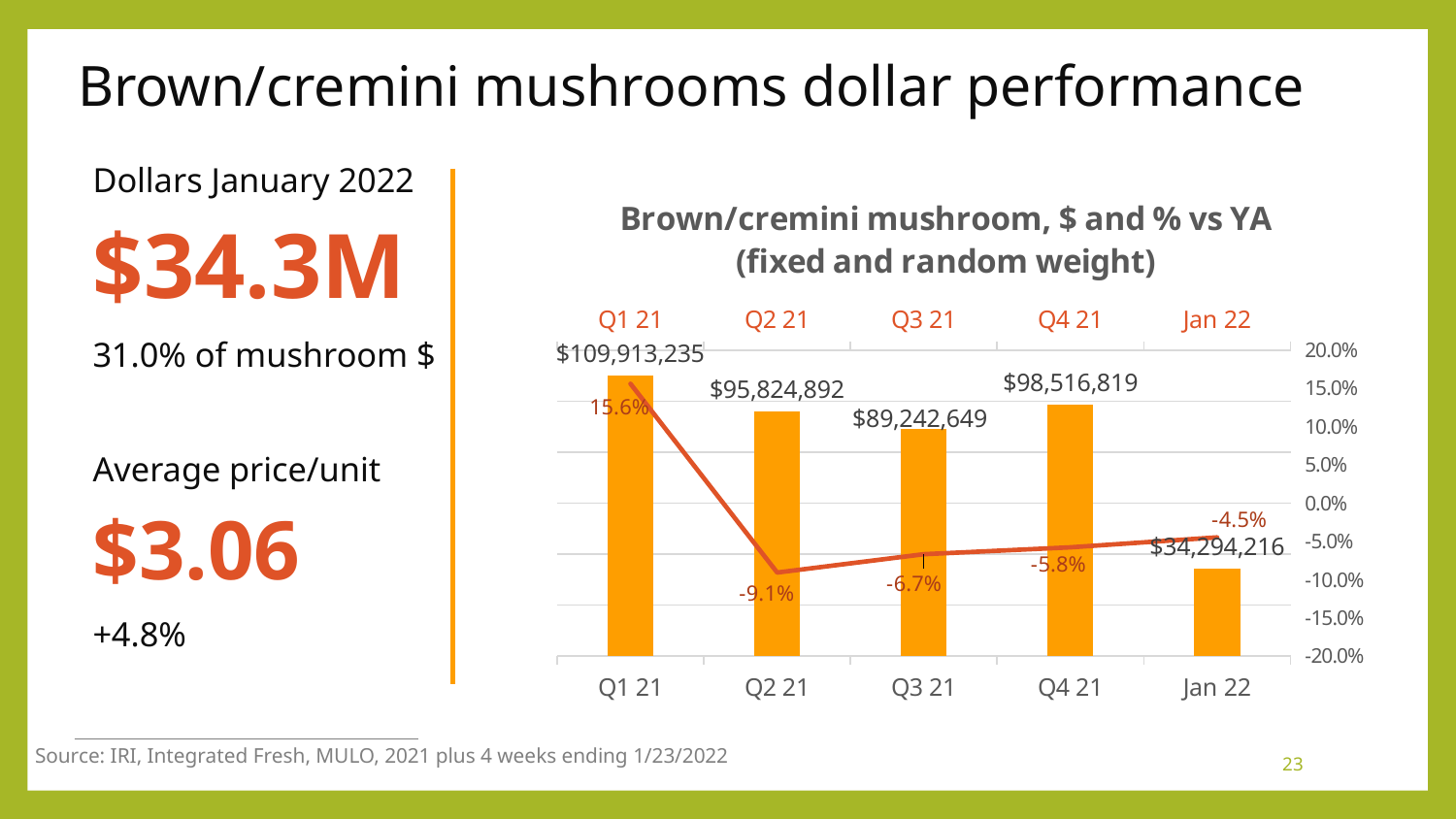
What is the difference in dollars between Q1 21 and Q2 21? $14,088,343 What is the % vs YA value for Q2 21 in the chart? -9.1% How many periods are shown on the x axis of the chart? 5 Does the % vs YA line rise or fall from Q2 21 to Jan 22? Rise What is the dollar value for Q1 21 in the chart? $109,913,235 What is the difference in dollars between Q4 21 and Q3 21? $9,274,170 What kind of chart is shown on the slide? Bar chart with a line Which has a larger dollar value, Q3 21 or Q4 21? Q4 21 Which period has the lowest % vs YA value in the chart? Q2 21 What is the dollar value for Jan 22 in the chart? $34,294,216 Which period has the highest dollar value in the chart? Q1 21 What is the % vs YA value for Q4 21 in the chart? -5.8%